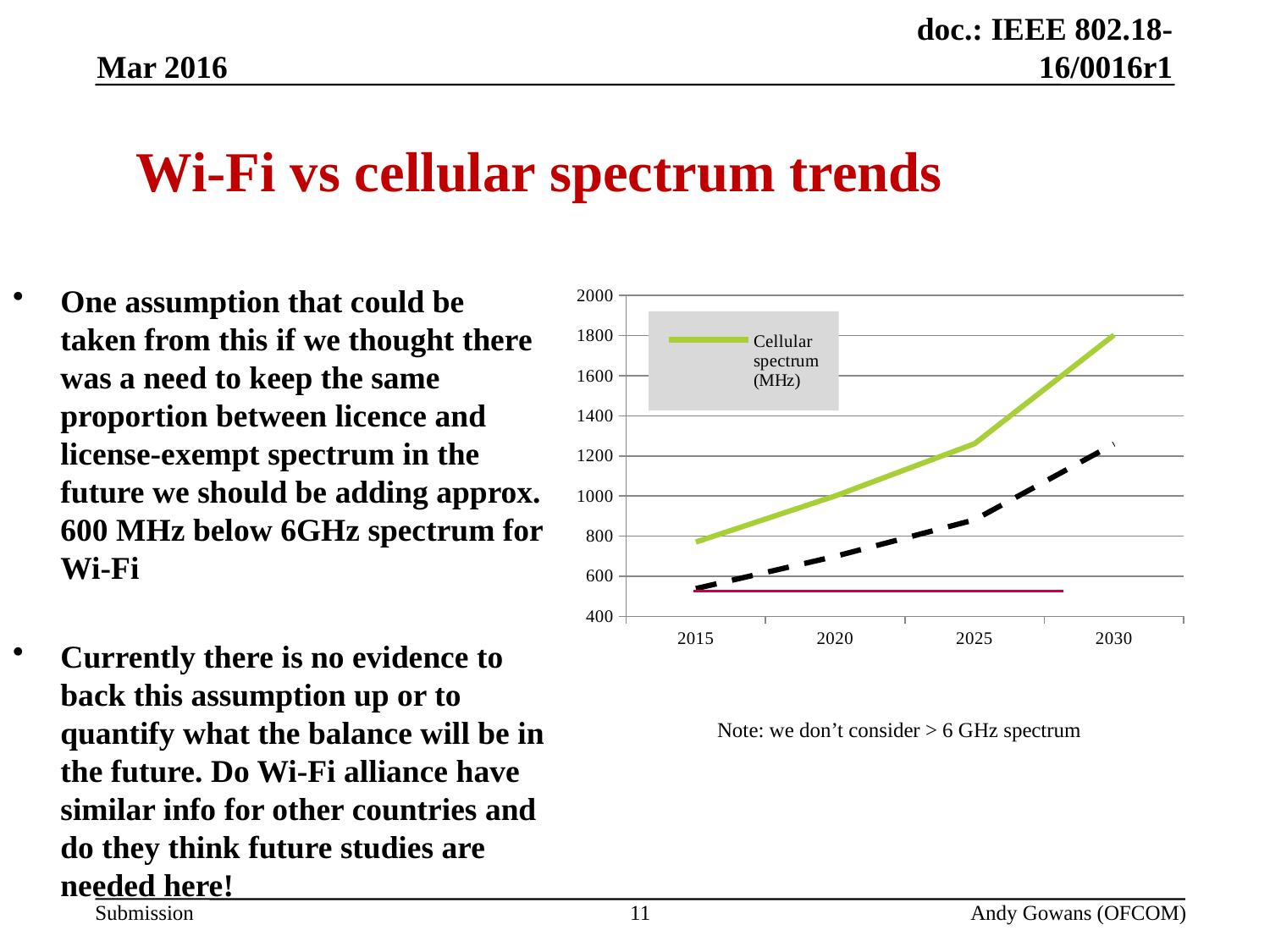
What kind of chart is shown on the slide? line chart In which year is the Cellular spectrum (MHz) line at its highest? 2030 What series name is shown in the chart legend? Cellular spectrum (MHz) At 2030, is the Cellular spectrum (MHz) line higher or lower than the black dashed line? higher Is the Cellular spectrum (MHz) value for 2030 greater or less than 1600? greater Is the Cellular spectrum (MHz) value for 2015 greater or less than 1000? less Does the Cellular spectrum (MHz) line rise or fall from 2015 to 2030? rise What colour is the Cellular spectrum (MHz) line? green In which year is the Cellular spectrum (MHz) line at its lowest? 2015 Is the Cellular spectrum (MHz) value for 2025 greater or less than 1200? greater How many years are marked on the x axis of the chart? 4